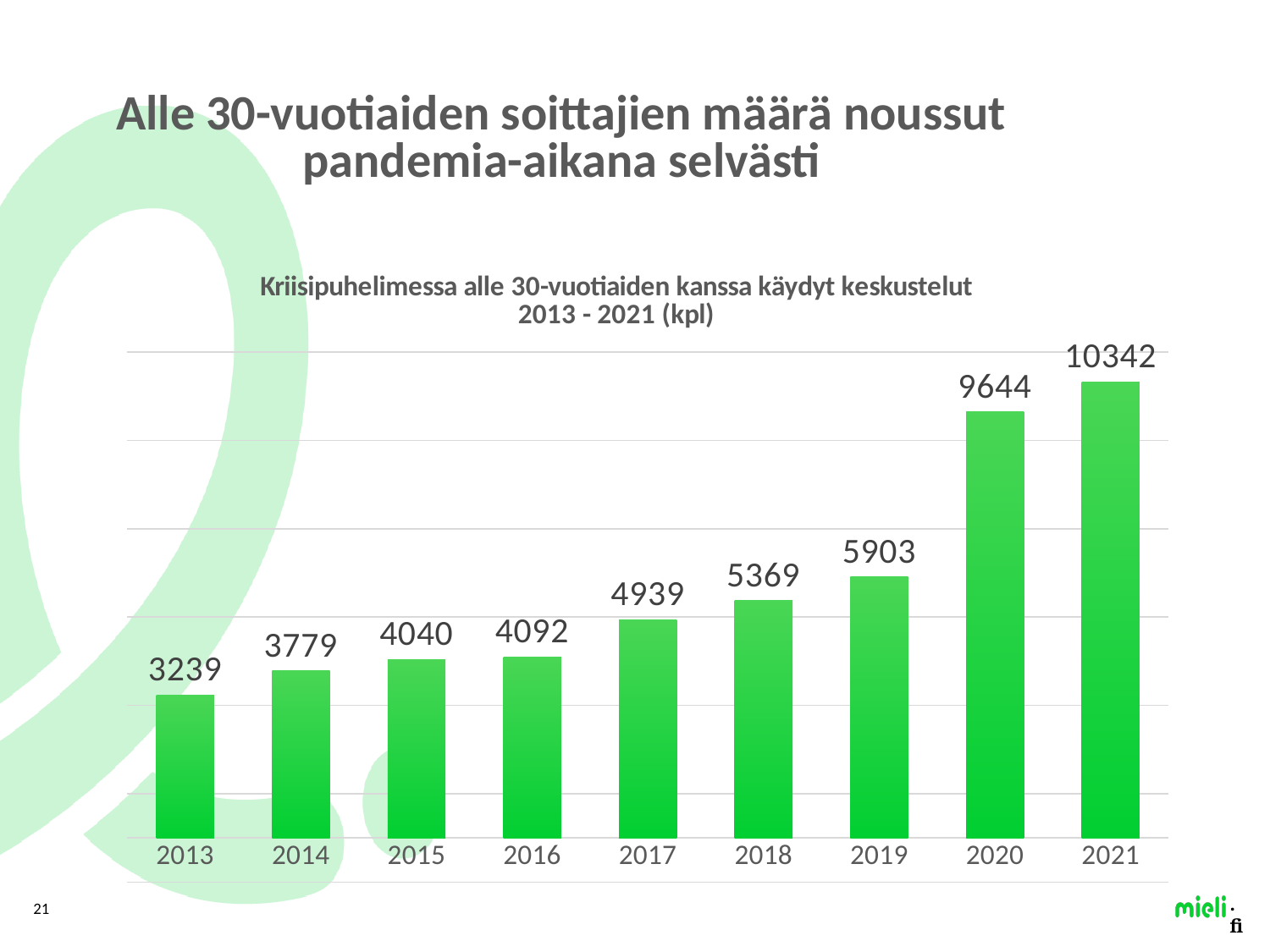
What is the value for 2020? 9644 What is the title of the chart? Kriisipuhelimessa alle 30-vuotiaiden kanssa käydyt keskustelut 2013 - 2021 (kpl) Which is larger, the value for 2016 or the value for 2018? 2018 Which year has the highest value? 2021 What is the difference between the values for 2021 and 2020? 698 What is the value for 2017? 4939 What is the difference between the values for 2019 and 2018? 534 What is the value for 2013? 3239 Which year has the lowest value? 2013 Do the values rise or fall from 2013 to 2021? rise What kind of chart is this? bar chart How many years are shown on the x axis? 9